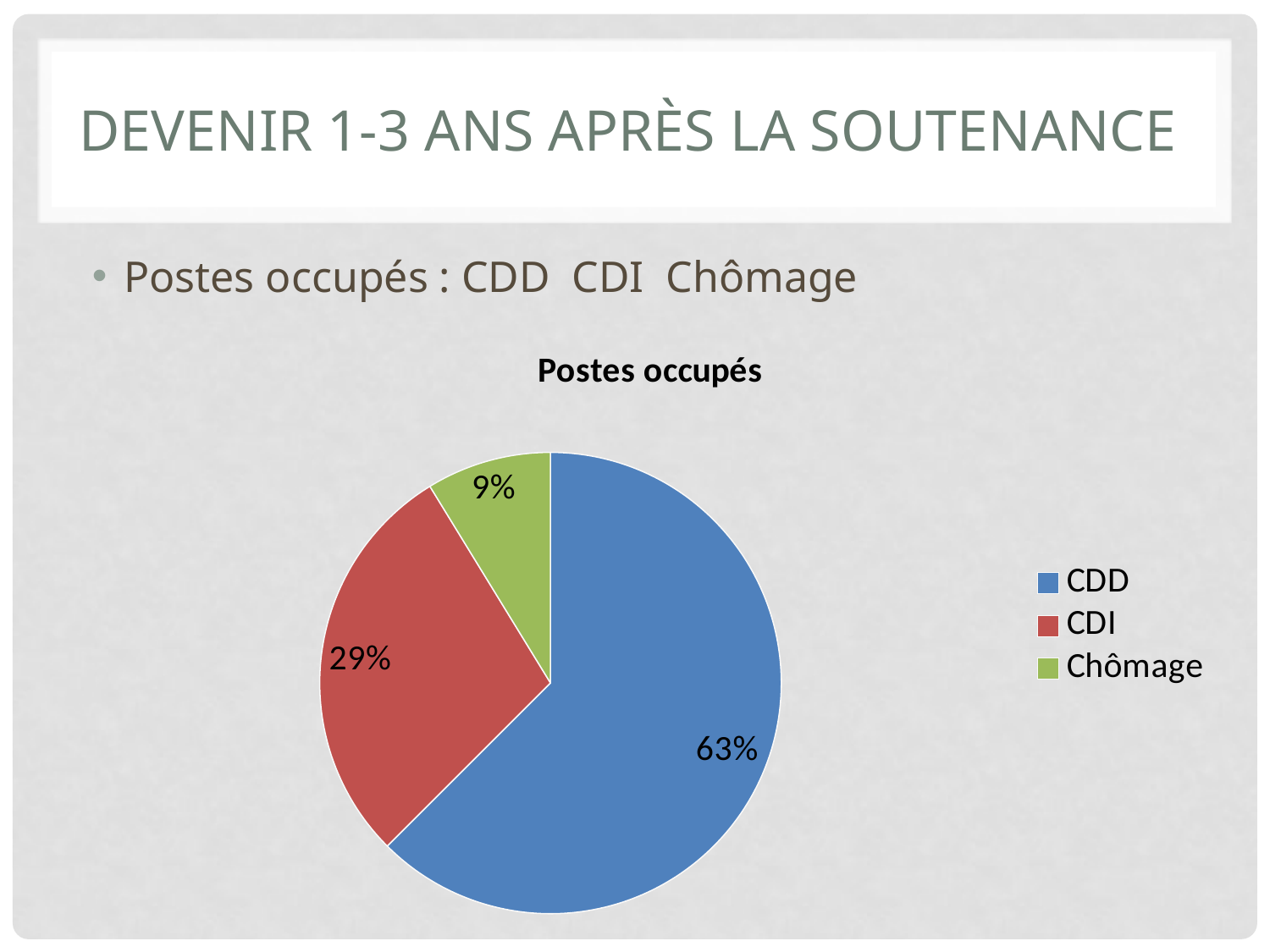
What share of the pie does CDI represent? 29% Which category has the largest slice of the pie? CDD What is the title of the chart? Postes occupés Which category has the smallest slice of the pie? Chômage What kind of chart is shown on the slide? Pie chart What is the difference in percentage points between the CDI and Chômage slices? 20 Which is larger, the CDI slice or the Chômage slice? CDI What colour is the CDI slice in the pie chart? Red What share of the pie does Chômage represent? 9% What share of the pie does CDD represent? 63% How many categories are shown in the pie chart? 3 What is the difference in percentage points between the CDD and CDI slices? 34